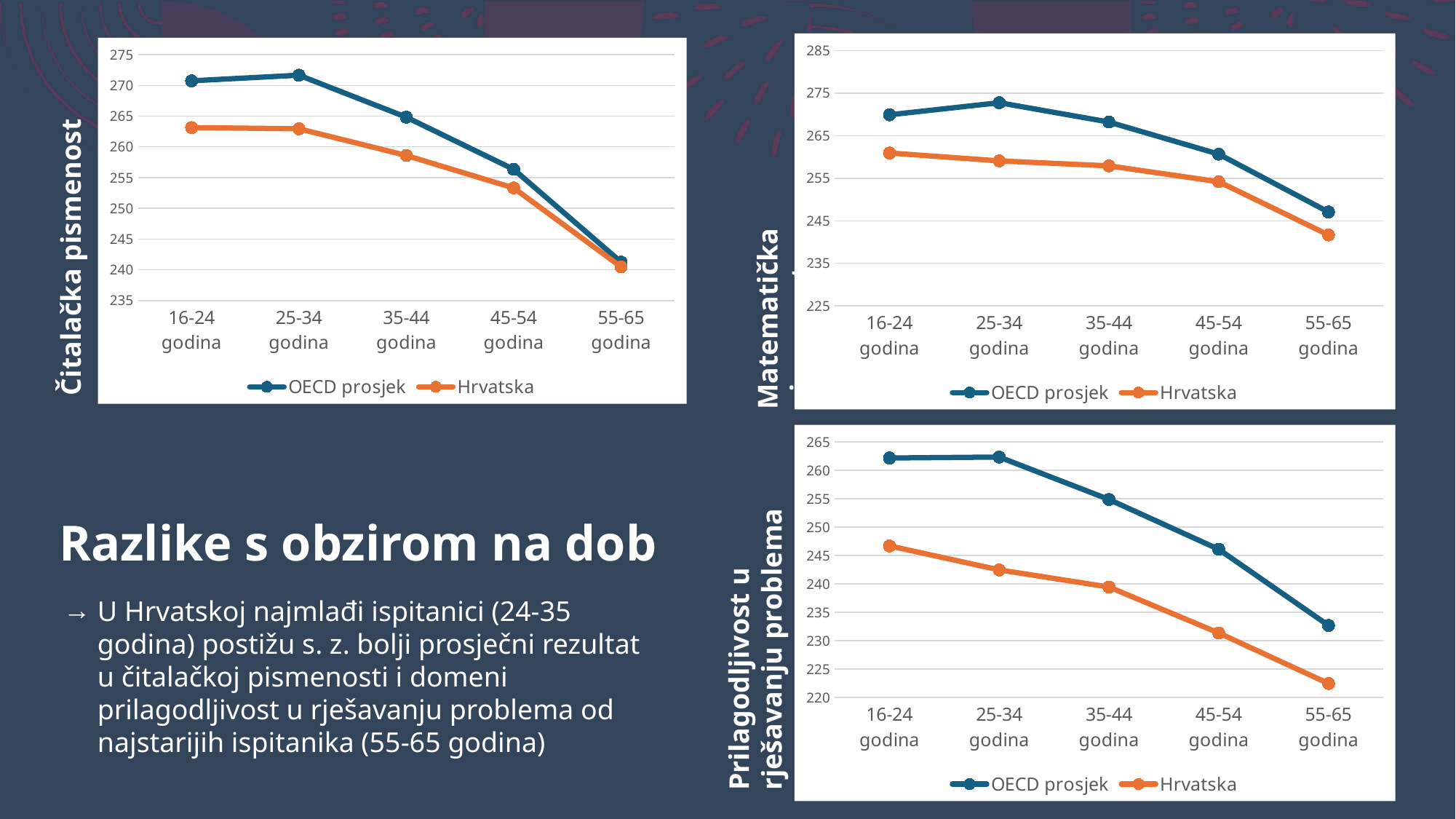
In the top-right chart 'Matematička', for which age group is the OECD prosjek value highest? 25-34 godina In the top-right chart 'Matematička', is the Hrvatska value for 55-65 godina greater or less than 245? less In the top-left chart 'Čitalačka pismenost', is the Hrvatska value for 16-24 godina greater or less than 260? greater How many series does the legend of the bottom-right chart 'Prilagodljivost u rješavanju problema' list? 2 How many age groups are shown on the x axis of the top-right chart 'Matematička'? 5 In the bottom-right chart 'Prilagodljivost u rješavanju problema', which series has the larger value for 45-54 godina, OECD prosjek or Hrvatska? OECD prosjek In the bottom-right chart 'Prilagodljivost u rješavanju problema', is the OECD prosjek value for 55-65 godina greater or less than 235? less In the bottom-right chart 'Prilagodljivost u rješavanju problema', do the Hrvatska values rise or fall from the 16-24 group to the 55-65 group? fall What colour is the Hrvatska line in the top-left chart 'Čitalačka pismenost'? orange What type of chart is the top-left chart titled 'Čitalačka pismenost'? line chart In the bottom-right chart 'Prilagodljivost u rješavanju problema', for which age group is the Hrvatska value lowest? 55-65 godina